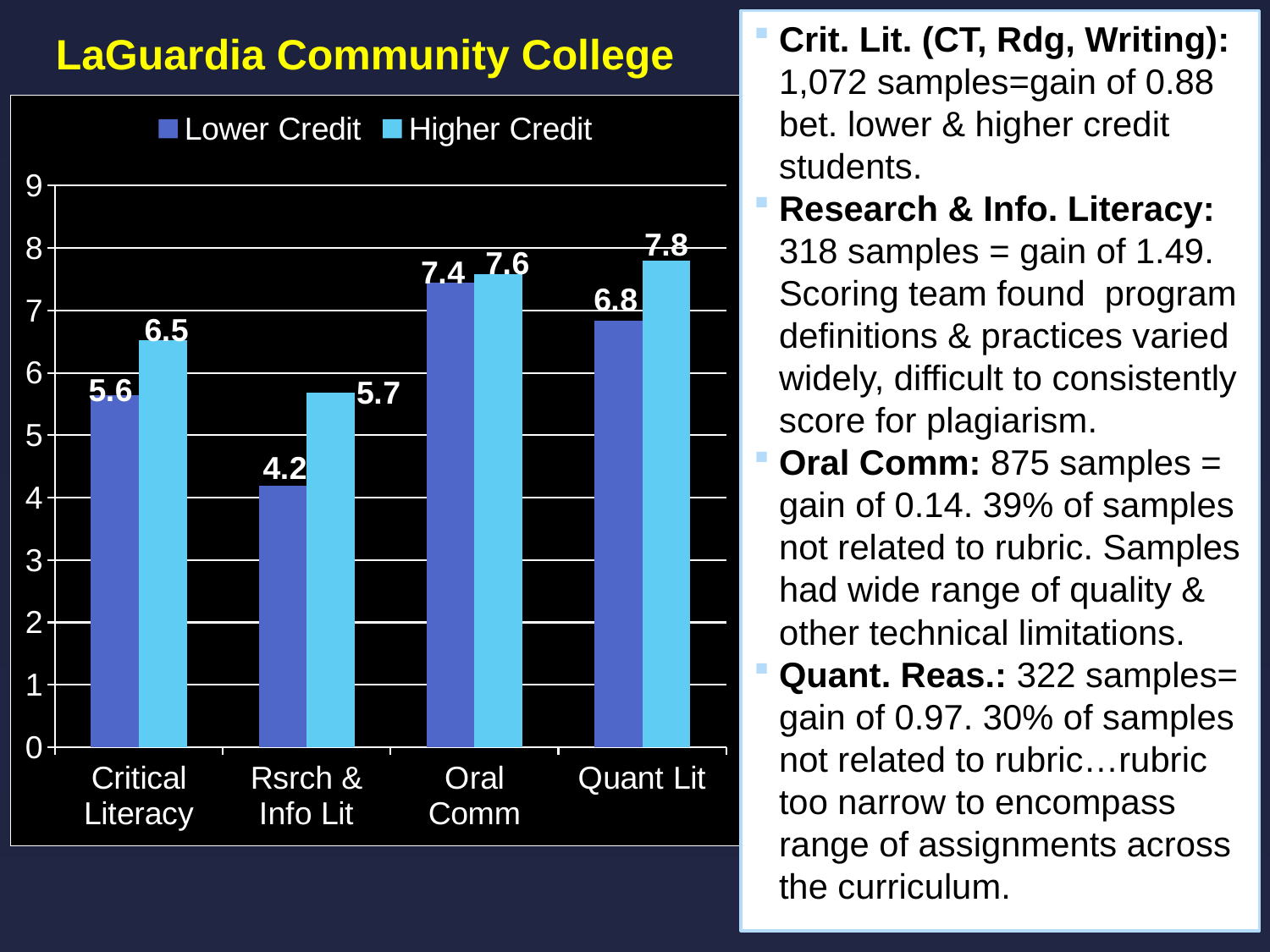
What is the Lower Credit value for Critical Literacy? 5.6 What is the Higher Credit value for Quant Lit? 7.8 What is the Lower Credit value for Oral Comm? 7.4 Which is larger: the Lower Credit value for Oral Comm or the Higher Credit value for Critical Literacy? Lower Credit value for Oral Comm What is the Higher Credit value for Rsrch & Info Lit? 5.7 What is the difference between the Higher Credit and Lower Credit values for Rsrch & Info Lit? 1.5 How many categories are shown on the x axis? 4 What is the difference between the Higher Credit and Lower Credit values for Quant Lit? 1.0 Which category has the highest Higher Credit value? Quant Lit How many series does the legend list? 2 Which category has the lowest Lower Credit value? Rsrch & Info Lit What kind of chart is shown on the slide? Bar chart